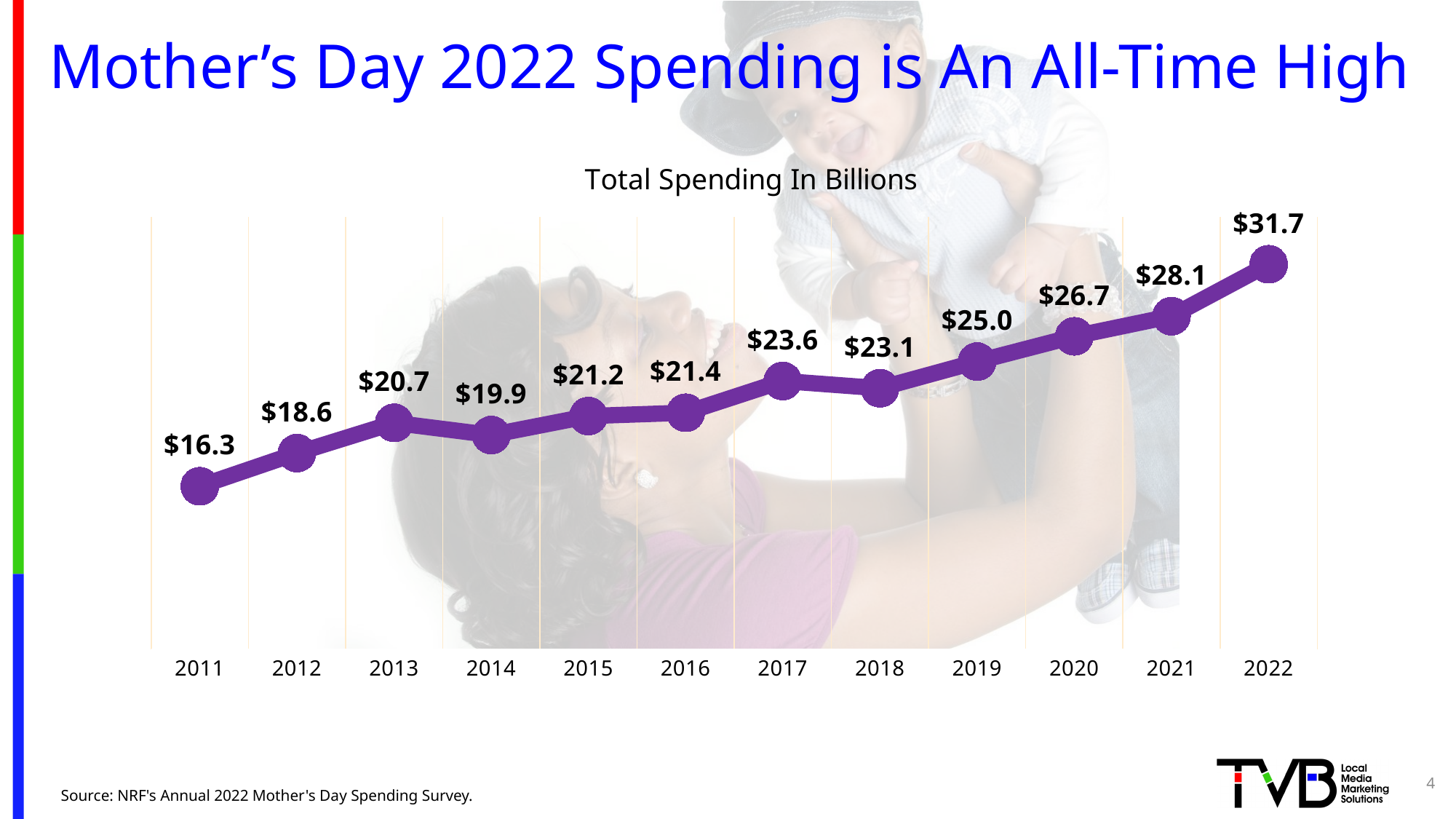
How many years are plotted on the chart? 12 What is the total spending value shown for 2018? $23.1 Overall, does total spending rise or fall from 2011 to 2022? Rise What is the title of the chart? Total Spending In Billions What is the difference in total spending between 2022 and 2021? $3.6 What is the difference in total spending between 2017 and 2018? $0.5 Which year has the highest total spending? 2022 Which year has higher total spending, 2013 or 2014? 2013 What is the total spending value shown for 2011? $16.3 Which year has the lowest total spending? 2011 What is the total spending value shown for 2022? $31.7 What kind of chart is shown on the slide? Line chart